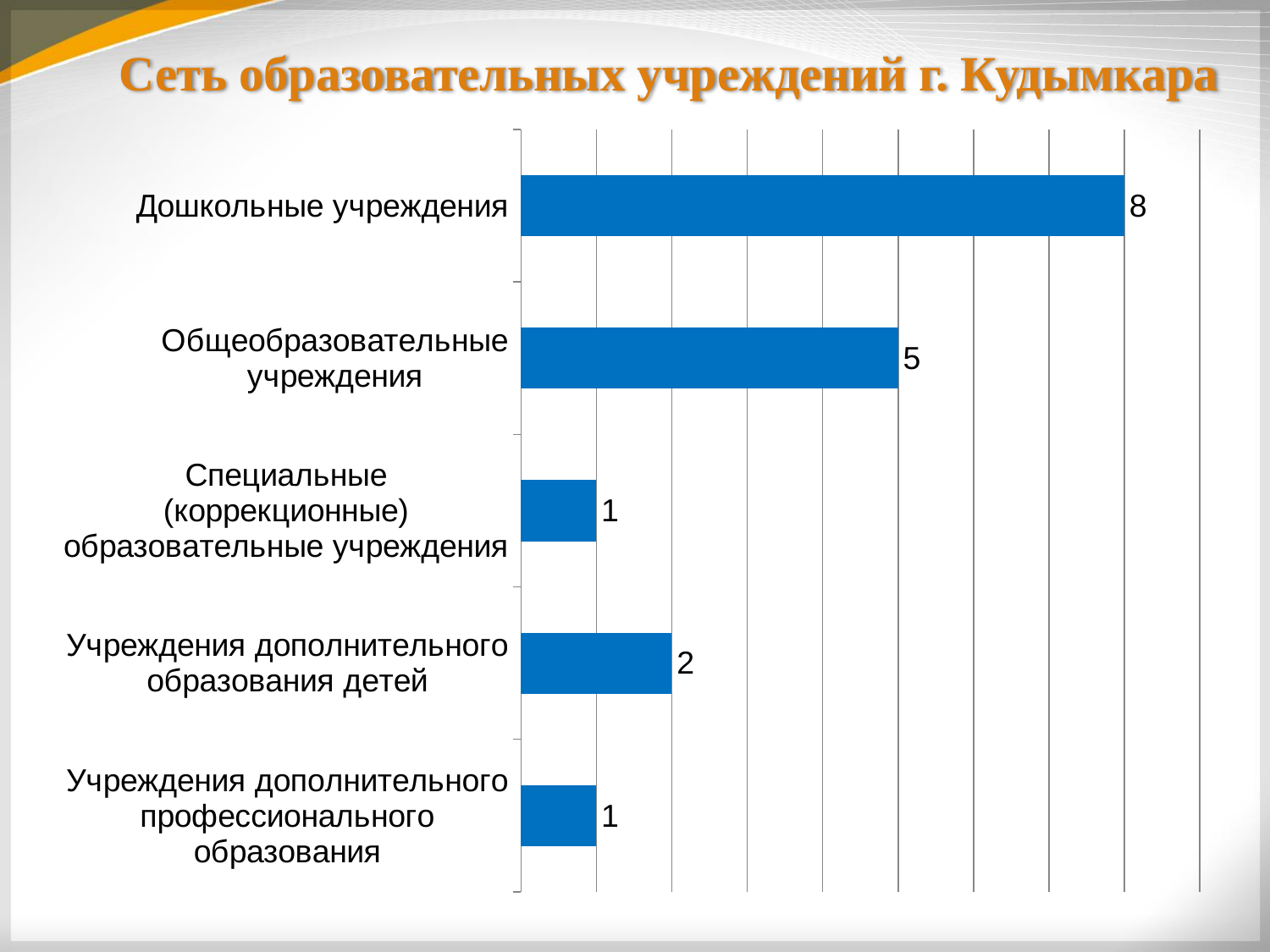
What is the value for Учреждения дополнительного образования детей? 2 What is the title of the slide? Сеть образовательных учреждений г. Кудымкара What colour are the bars in the chart? Blue What is the difference between the values for Учреждения дополнительного образования детей and Учреждения дополнительного профессионального образования? 1 What is the value for Специальные (коррекционные) образовательные учреждения? 1 Which category has the highest value? Дошкольные учреждения How many categories are shown in the chart? 5 What kind of chart is shown on the slide? Bar chart What is the value for Общеобразовательные учреждения? 5 What is the difference between the values for Дошкольные учреждения and Общеобразовательные учреждения? 3 Which is larger: the value for Общеобразовательные учреждения or the value for Учреждения дополнительного образования детей? Общеобразовательные учреждения What is the value for Дошкольные учреждения? 8